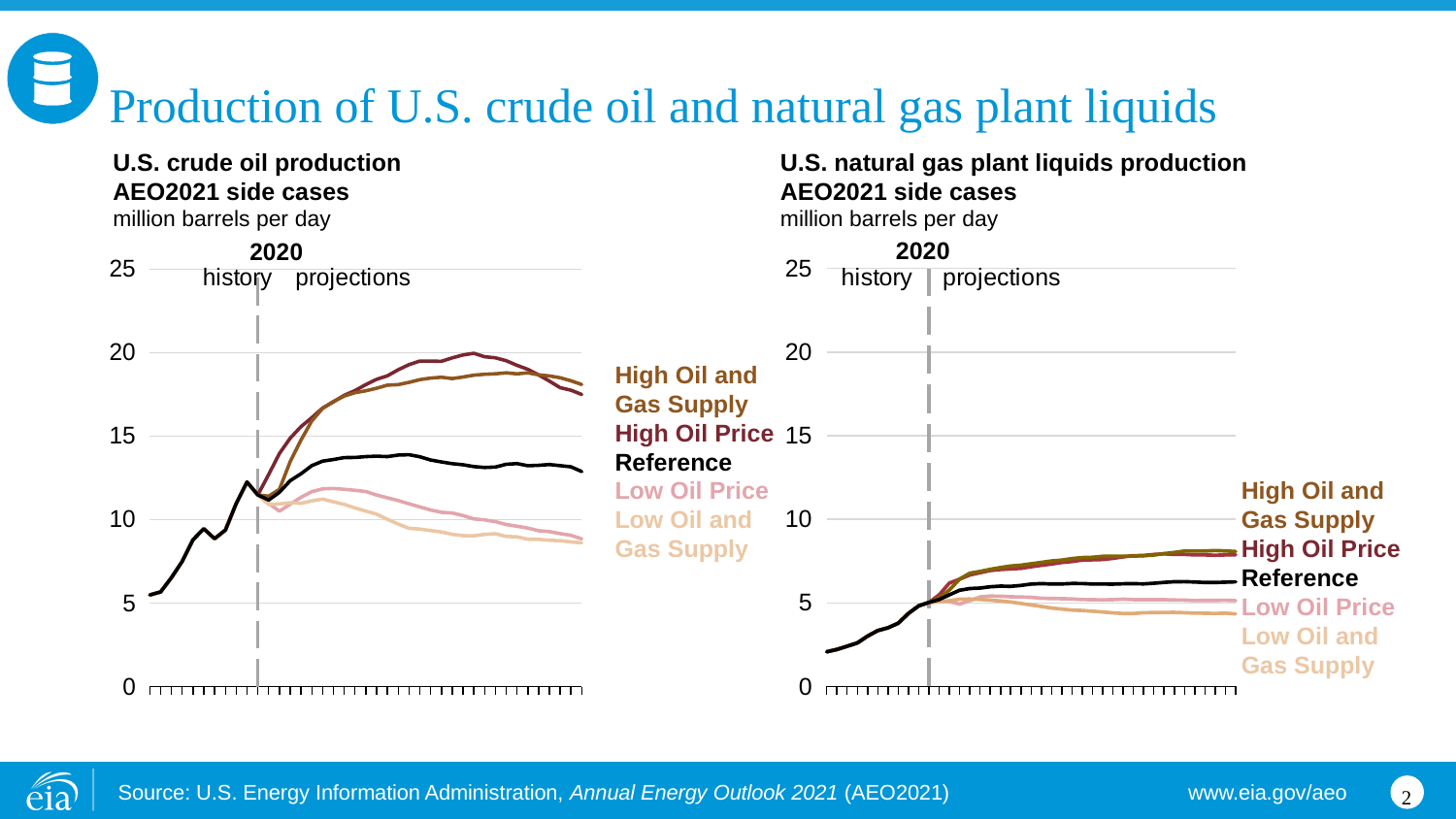
In the U.S. crude oil production chart, is the value for the Low Oil and Gas Supply case at the end of the projection period greater or less than 10? less In the U.S. natural gas plant liquids production chart, which case has the lowest value at the end of the projection period? Low Oil and Gas Supply What kind of chart is the U.S. crude oil production chart on the left? line chart In the U.S. natural gas plant liquids production chart, is the value for the High Oil and Gas Supply case at the end of the projection period greater or less than 10? less In the U.S. natural gas plant liquids production chart, does the line rise or fall over the history period? rise What unit is used on the y axis of both charts? million barrels per day In the U.S. crude oil production chart, is the value for the High Oil and Gas Supply case at the end of the projection period greater or less than 15? greater In the U.S. crude oil production chart, which is larger at the end of the projection period: the Reference case or the Low Oil Price case? Reference In the U.S. crude oil production chart, does the Low Oil and Gas Supply line rise or fall over the projection period? fall How many series does the legend of the U.S. natural gas plant liquids production chart list? 5